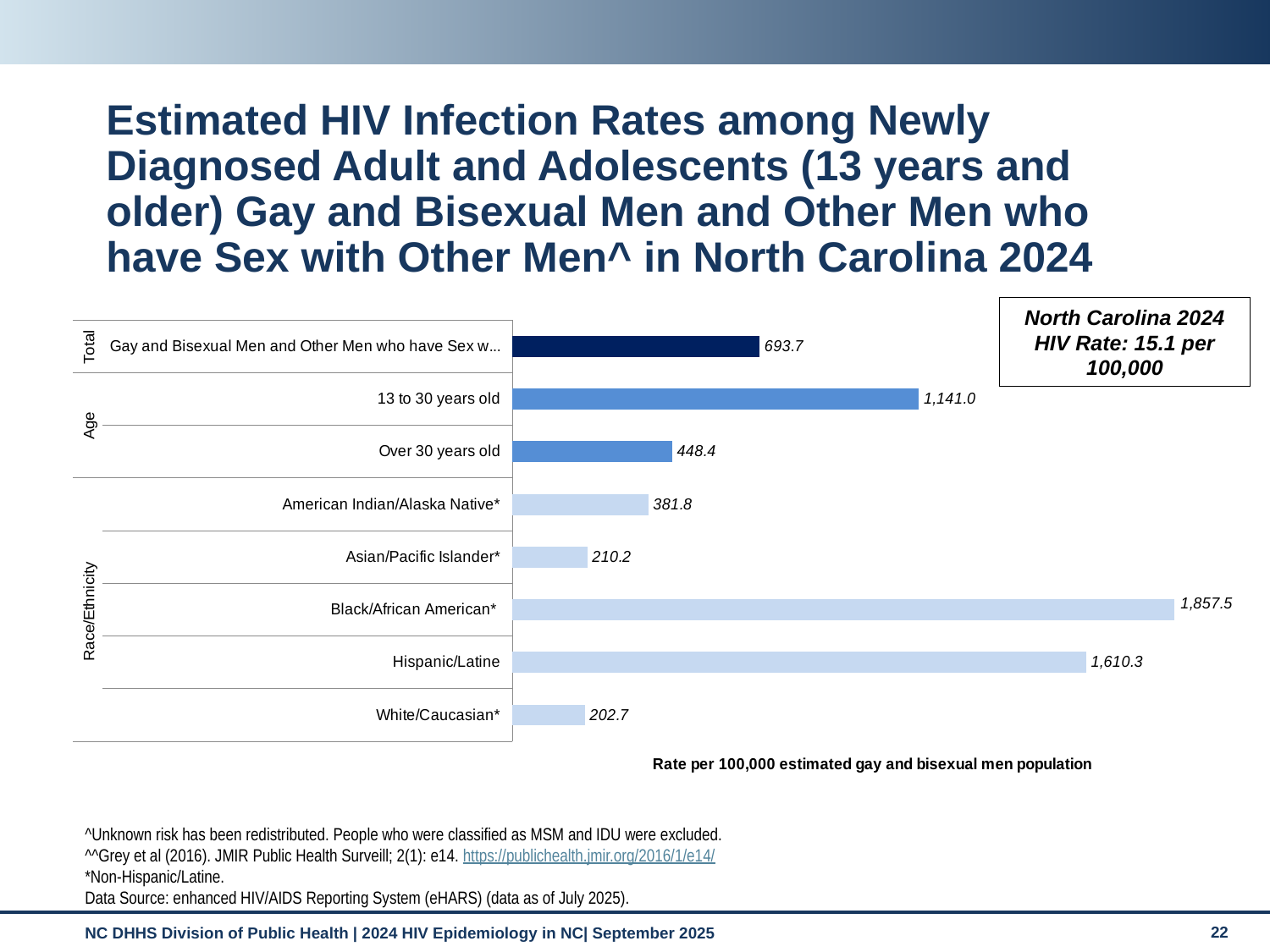
How many bars are plotted in the chart? 8 What is the estimated HIV infection rate for Black/African American*? 1,857.5 Which category has the highest estimated HIV infection rate? Black/African American* Which has a higher rate, Asian/Pacific Islander* or White/Caucasian*? Asian/Pacific Islander* What is the difference between the rates for 13 to 30 years old and Over 30 years old? 692.6 What is the difference between the rates for Black/African American* and Hispanic/Latine? 247.2 What is the estimated HIV infection rate for Over 30 years old? 448.4 Which category has the lowest estimated HIV infection rate? White/Caucasian* What is the estimated HIV infection rate for 13 to 30 years old? 1,141.0 What kind of chart is shown on the slide? Bar chart What is the estimated HIV infection rate for White/Caucasian*? 202.7 What is the estimated HIV infection rate for Hispanic/Latine? 1,610.3